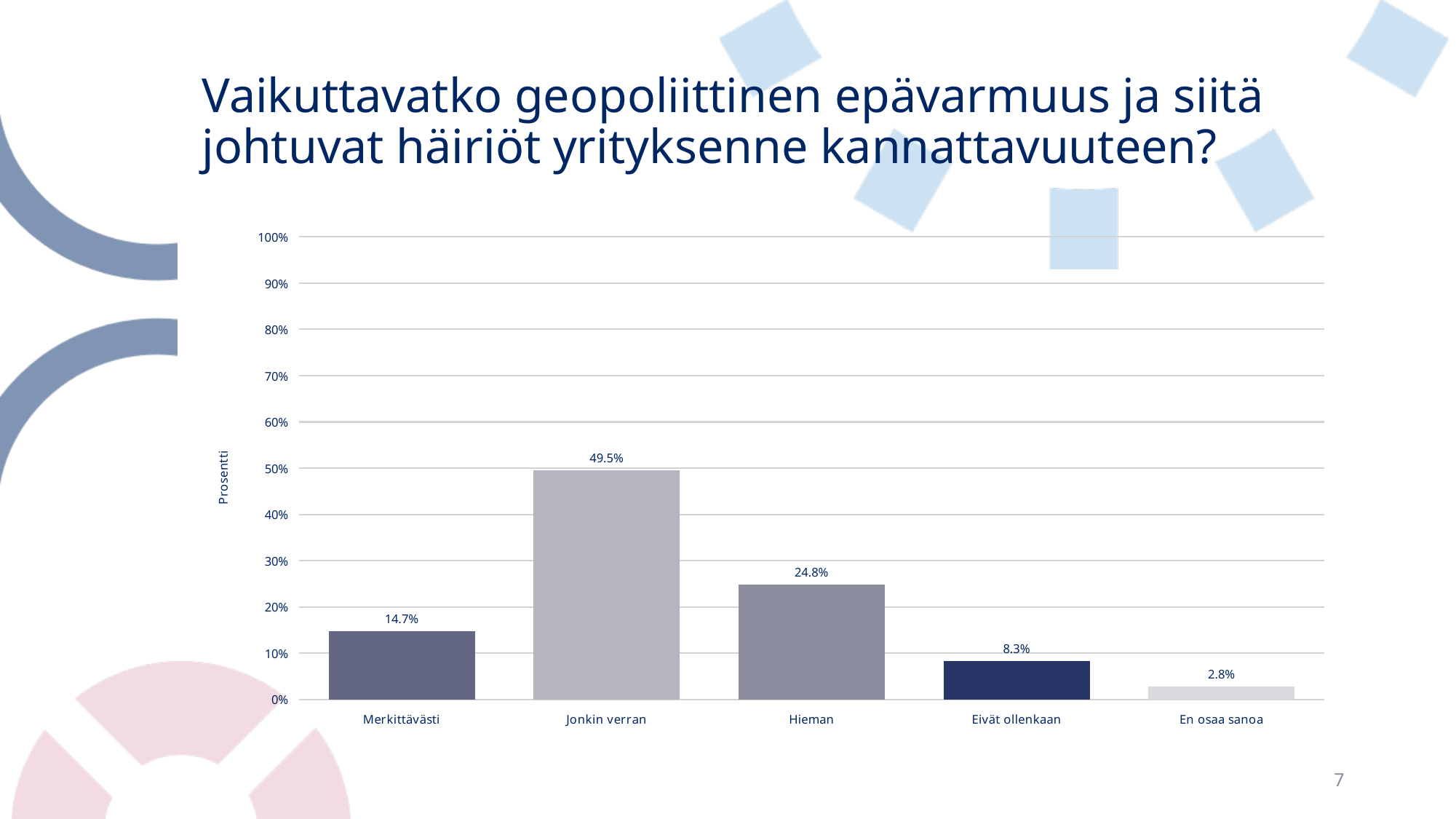
What is the difference between the values for Jonkin verran and Hieman? 24.7% What is the value for Merkittävästi? 14.7% What is the difference between the values for Merkittävästi and Eivät ollenkaan? 6.4% What is the value for Jonkin verran? 49.5% Which category has the highest value? Jonkin verran What is the label of the y axis? Prosentti Which category has the lowest value? En osaa sanoa How many categories are shown on the x axis? 5 Is the value for Hieman greater or less than 20%? greater What is the value for En osaa sanoa? 2.8% What kind of chart is shown on the slide? bar chart Which is larger, the value for Hieman or the value for Merkittävästi? Hieman